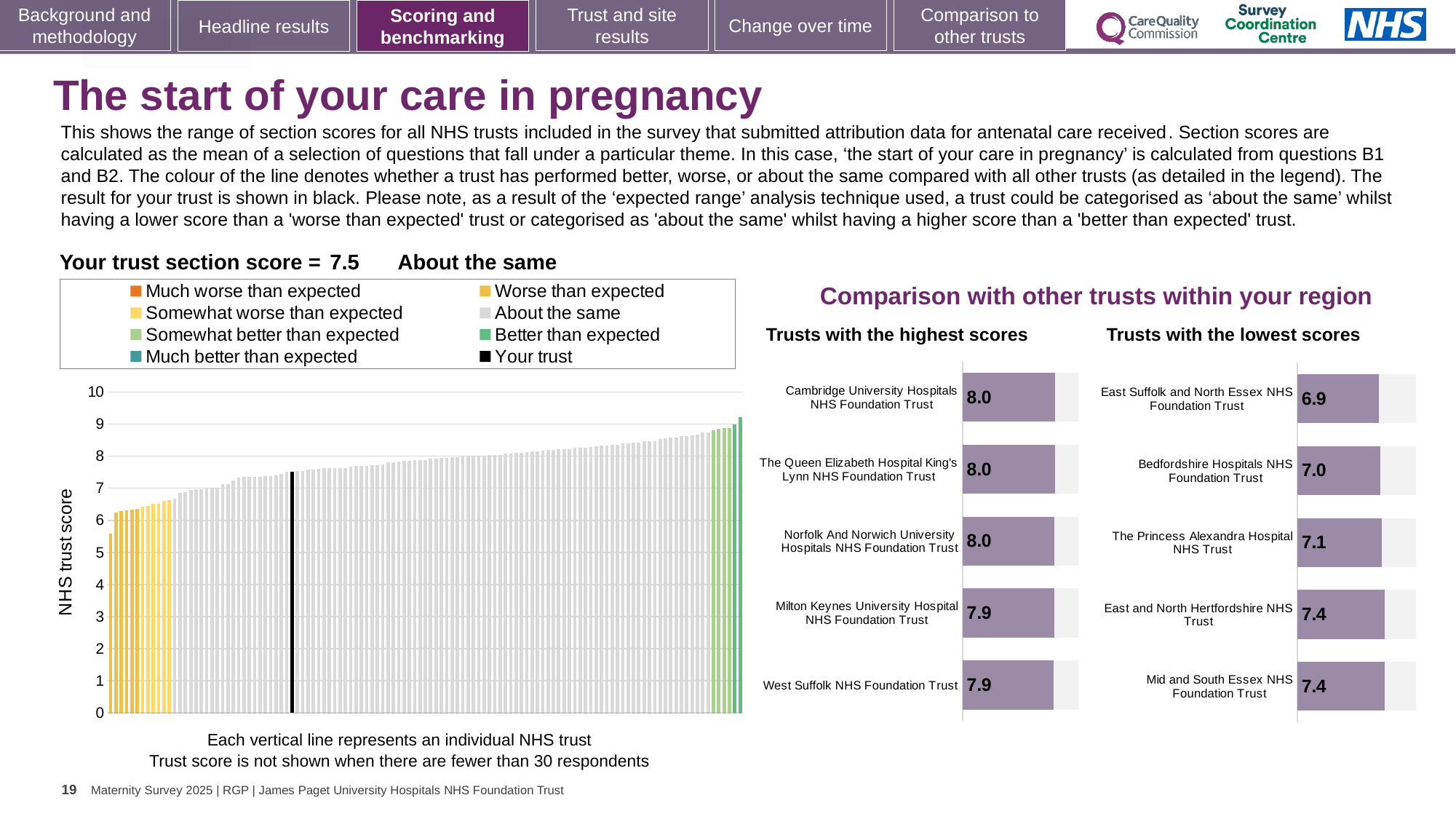
What is the label on the vertical axis of the main chart? NHS trust score On the 'Trusts with the highest scores' chart, what is the score for Milton Keynes University Hospital NHS Foundation Trust? 7.9 How many trusts are shown on the 'Trusts with the highest scores' chart? 5 What kind of chart is the main chart showing the range of NHS trust scores? bar chart On the 'Trusts with the lowest scores' chart, what is the score for Bedfordshire Hospitals NHS Foundation Trust? 7.0 On the main chart of NHS trust scores, do the values rise or fall from left to right? rise On the 'Trusts with the lowest scores' chart, which has the higher score: Bedfordshire Hospitals NHS Foundation Trust or The Princess Alexandra Hospital NHS Trust? The Princess Alexandra Hospital NHS Trust How many entries does the legend above the main chart list? 8 On the main chart of NHS trust scores, what is the section score for your trust? 7.5 On the 'Trusts with the lowest scores' chart, what is the difference between the scores of Mid and South Essex NHS Foundation Trust and East Suffolk and North Essex NHS Foundation Trust? 0.5 On the 'Trusts with the lowest scores' chart, which trust has the lowest score? East Suffolk and North Essex NHS Foundation Trust On the 'Trusts with the highest scores' chart, what is the difference between the score for Cambridge University Hospitals NHS Foundation Trust and West Suffolk NHS Foundation Trust? 0.1